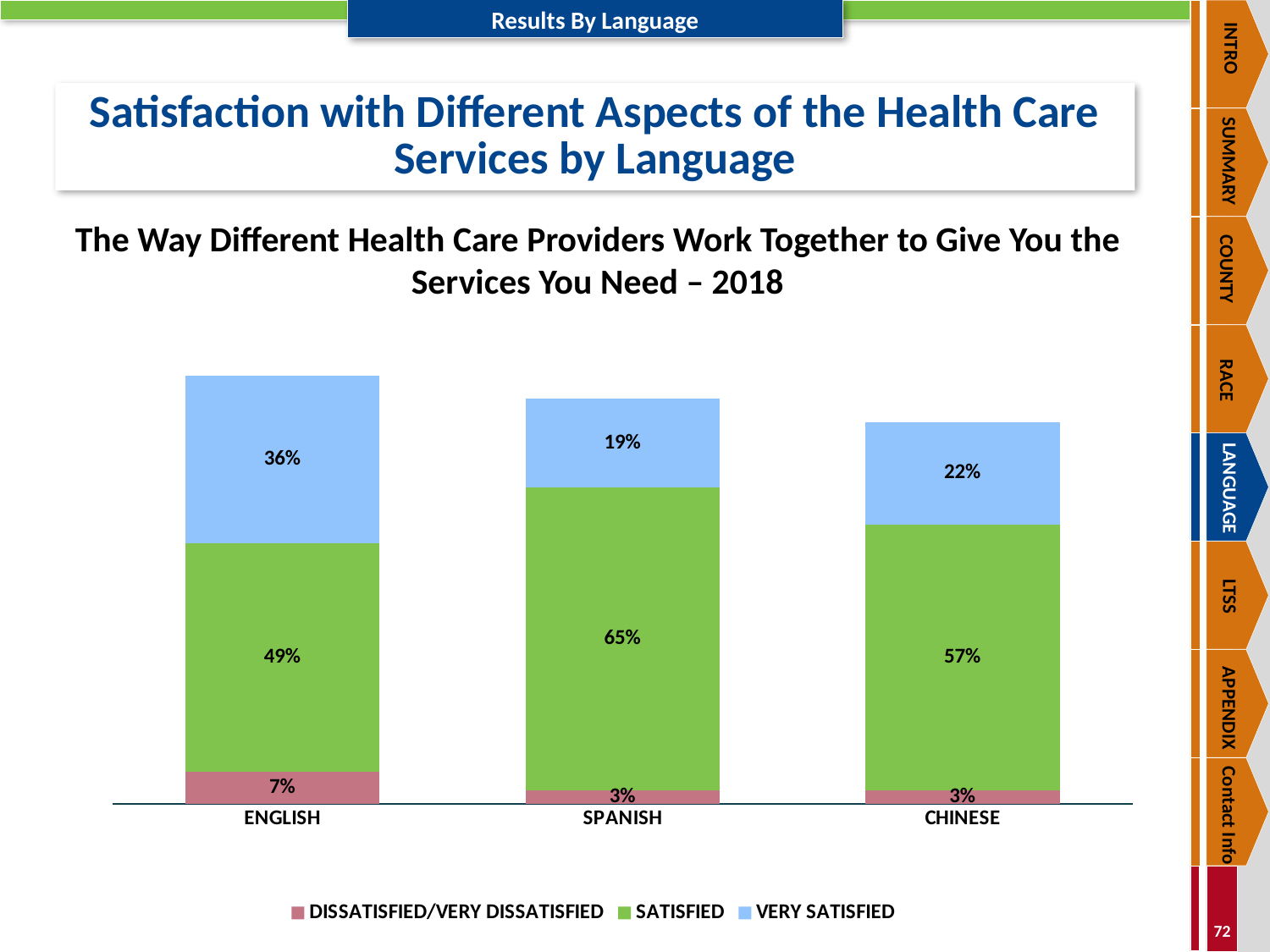
Which colour represents the Very Satisfied series in the legend? Blue Which language group has the lowest Very Satisfied percentage? Spanish What percentage of English speakers were Very Satisfied? 36% What is the total of the three labelled segments in the Spanish bar? 87% What percentage of Spanish speakers were Satisfied? 65% Which language group has the highest Satisfied percentage? Spanish What percentage of Chinese speakers were Dissatisfied/Very Dissatisfied? 3% What is the difference between the Very Satisfied percentages for English and Chinese speakers? 14% How many language groups are shown on the x axis? 3 How many series does the legend list? 3 What kind of chart is shown on the slide? Stacked bar chart Which is larger: the Satisfied percentage for Chinese speakers or for English speakers? Chinese